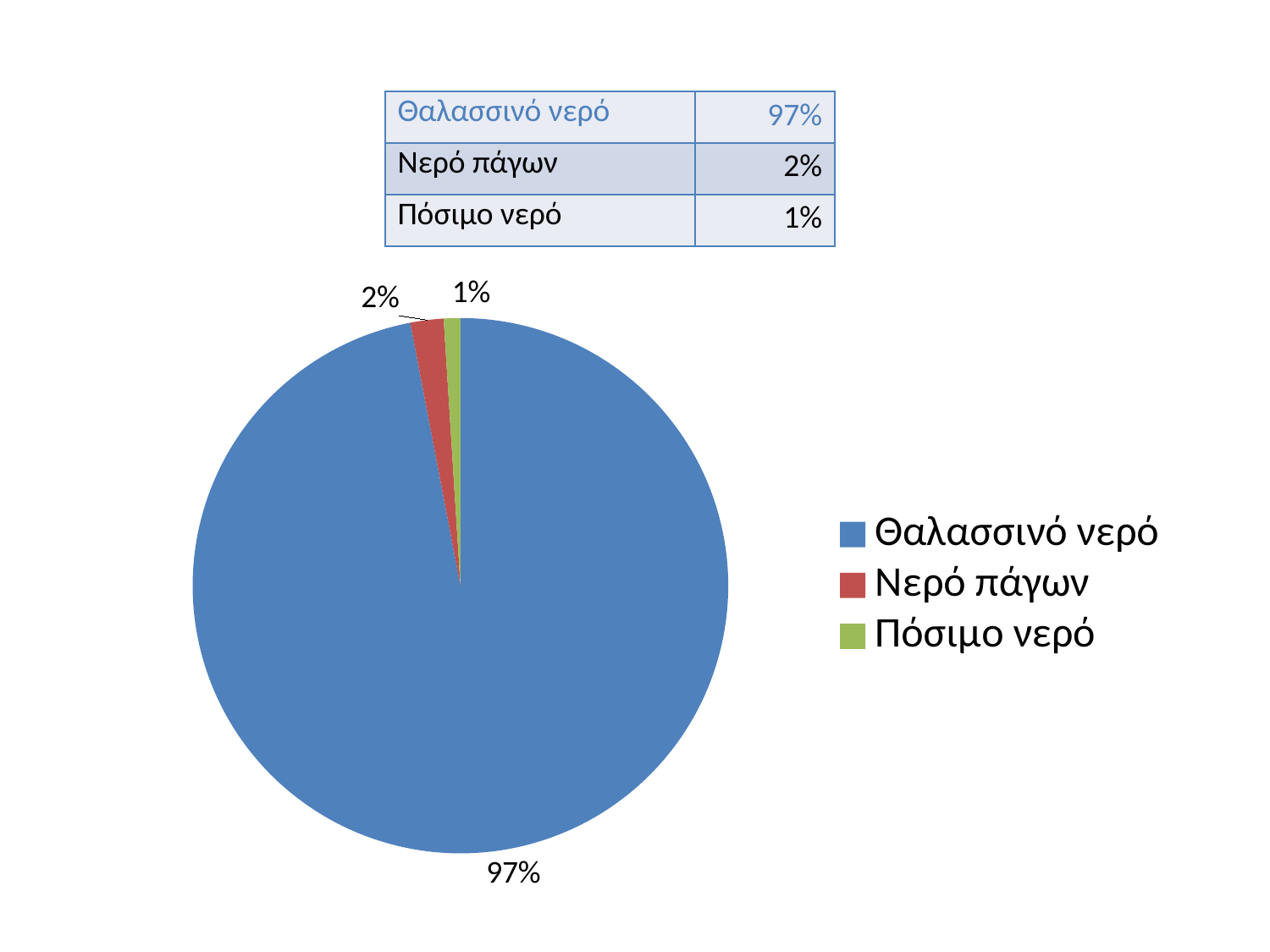
What is the difference between the shares of Θαλασσινό νερό and Νερό πάγων? 95% What kind of chart is shown on the slide? pie chart Which category has the smallest slice of the pie? Πόσιμο νερό What is the difference between the shares of Νερό πάγων and Πόσιμο νερό? 1% Which is larger, the slice for Νερό πάγων or the slice for Πόσιμο νερό? Νερό πάγων What share of the pie does Θαλασσινό νερό have? 97% How many entries does the legend list? 3 What share of the pie does Πόσιμο νερό have? 1% Which category has the largest slice of the pie? Θαλασσινό νερό How many slices does the pie chart have? 3 What share of the pie does Νερό πάγων have? 2% What colour is the slice for Πόσιμο νερό? green